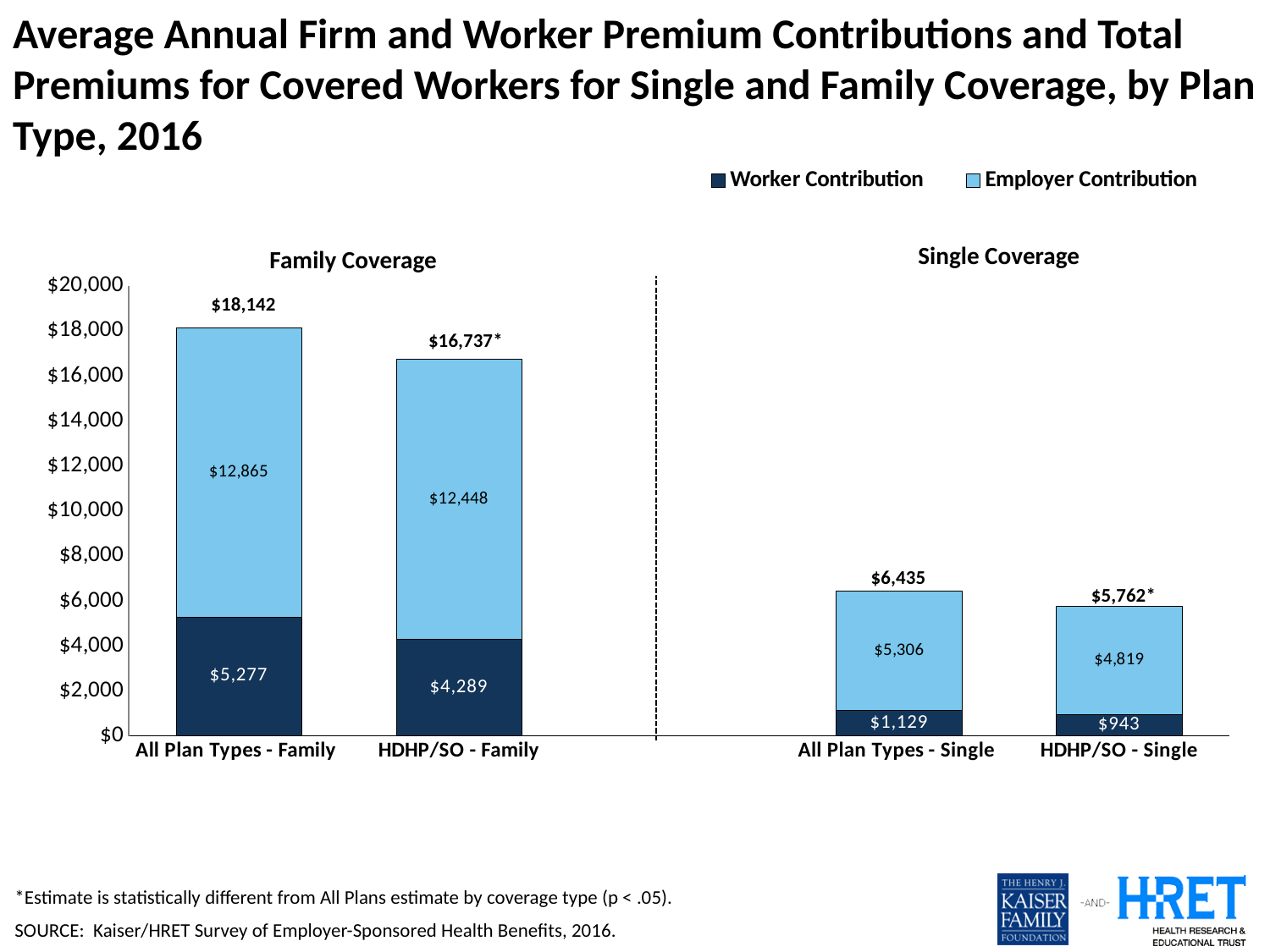
What is the Worker Contribution for All Plan Types - Family? $5,277 What is the Employer Contribution for All Plan Types - Single? $5,306 What is the difference between the Worker Contribution for All Plan Types - Family and HDHP/SO - Family? $988 What is the total premium shown above the HDHP/SO - Family bar? $16,737* Which category has the highest total premium? All Plan Types - Family What is the total premium shown above the All Plan Types - Single bar? $6,435 Which category has the lowest Worker Contribution? HDHP/SO - Single What is the difference between the Employer Contribution for All Plan Types - Single and HDHP/SO - Single? $487 How many series does the legend list? 2 What is the Employer Contribution for HDHP/SO - Single? $4,819 Which is larger, the Employer Contribution for All Plan Types - Family or for HDHP/SO - Family? All Plan Types - Family What kind of chart is shown on the slide? Stacked bar chart